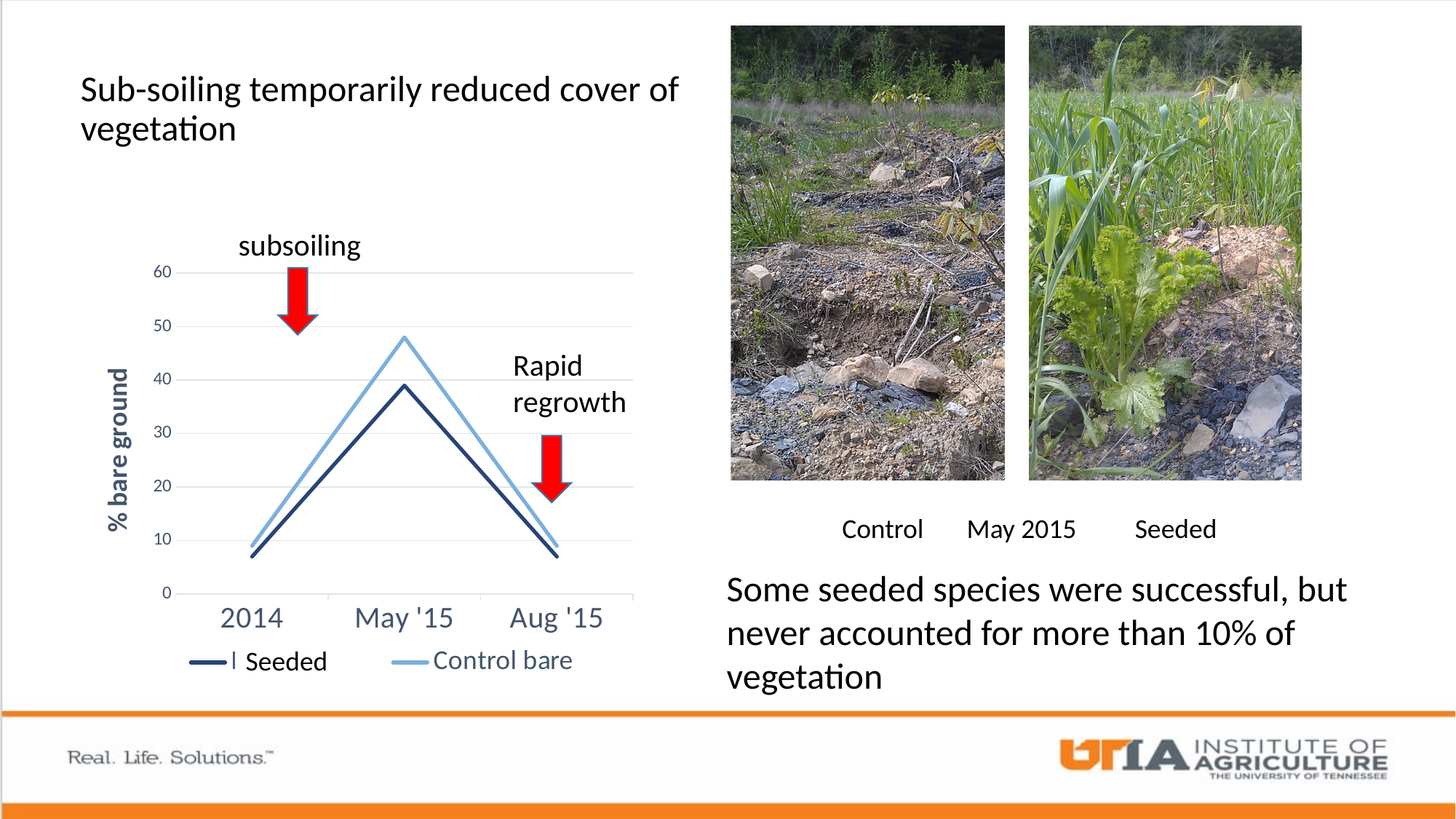
Is the Control bare value for May '15 greater or less than 40? greater How many time points are plotted along the x axis of the chart? 3 Is the Control bare value for Aug '15 greater or less than 20? less Is the Seeded value for May '15 greater or less than 30? greater What is the label on the y axis of the chart? % bare ground At which time point is the Seeded series highest? May '15 What kind of chart is shown on the slide? line chart Do the values fall or rise from May '15 to Aug '15? fall In May '15, which series has the larger value, Seeded or Control bare? Control bare At which time point is the Control bare series highest? May '15 How many series does the chart legend list? 2